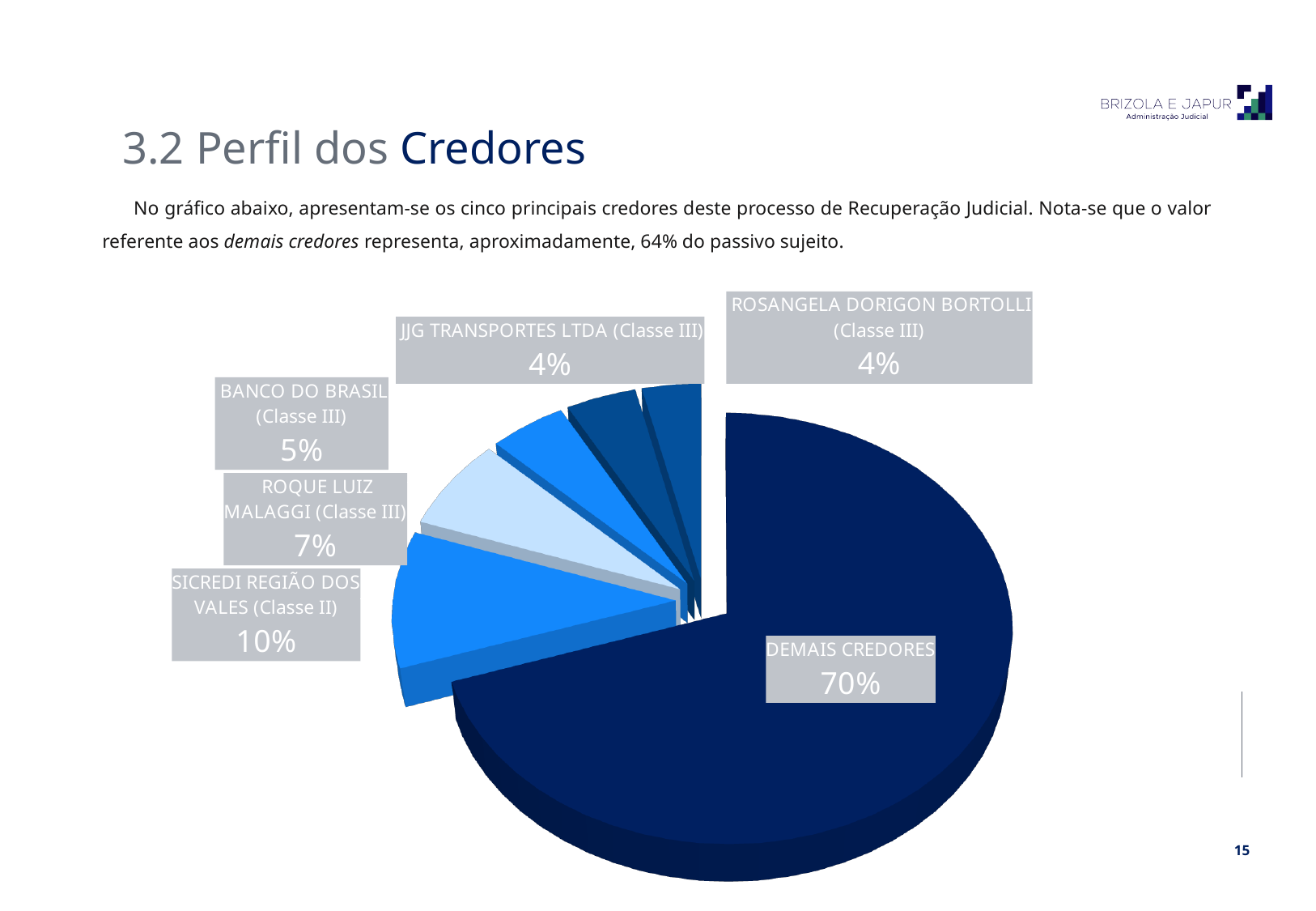
How many slices does the pie chart have? 6 What is the value shown for BANCO DO BRASIL (Classe III)? 5% What is the value shown for ROQUE LUIZ MALAGGI (Classe III)? 7% What is the value shown for SICREDI REGIÃO DOS VALES (Classe II)? 10% Which category has the largest slice of the pie? DEMAIS CREDORES Which is larger, the share of ROQUE LUIZ MALAGGI (Classe III) or BANCO DO BRASIL (Classe III)? ROQUE LUIZ MALAGGI (Classe III) What is the combined share of the five named creditors other than DEMAIS CREDORES? 30% What kind of chart is shown on the slide? Pie chart What is the difference between the shares of DEMAIS CREDORES and SICREDI REGIÃO DOS VALES (Classe II)? 60% What share of the pie does DEMAIS CREDORES represent? 70% What is the value shown for JJG TRANSPORTES LTDA (Classe III)? 4% What is the value shown for ROSANGELA DORIGON BORTOLLI (Classe III)? 4%